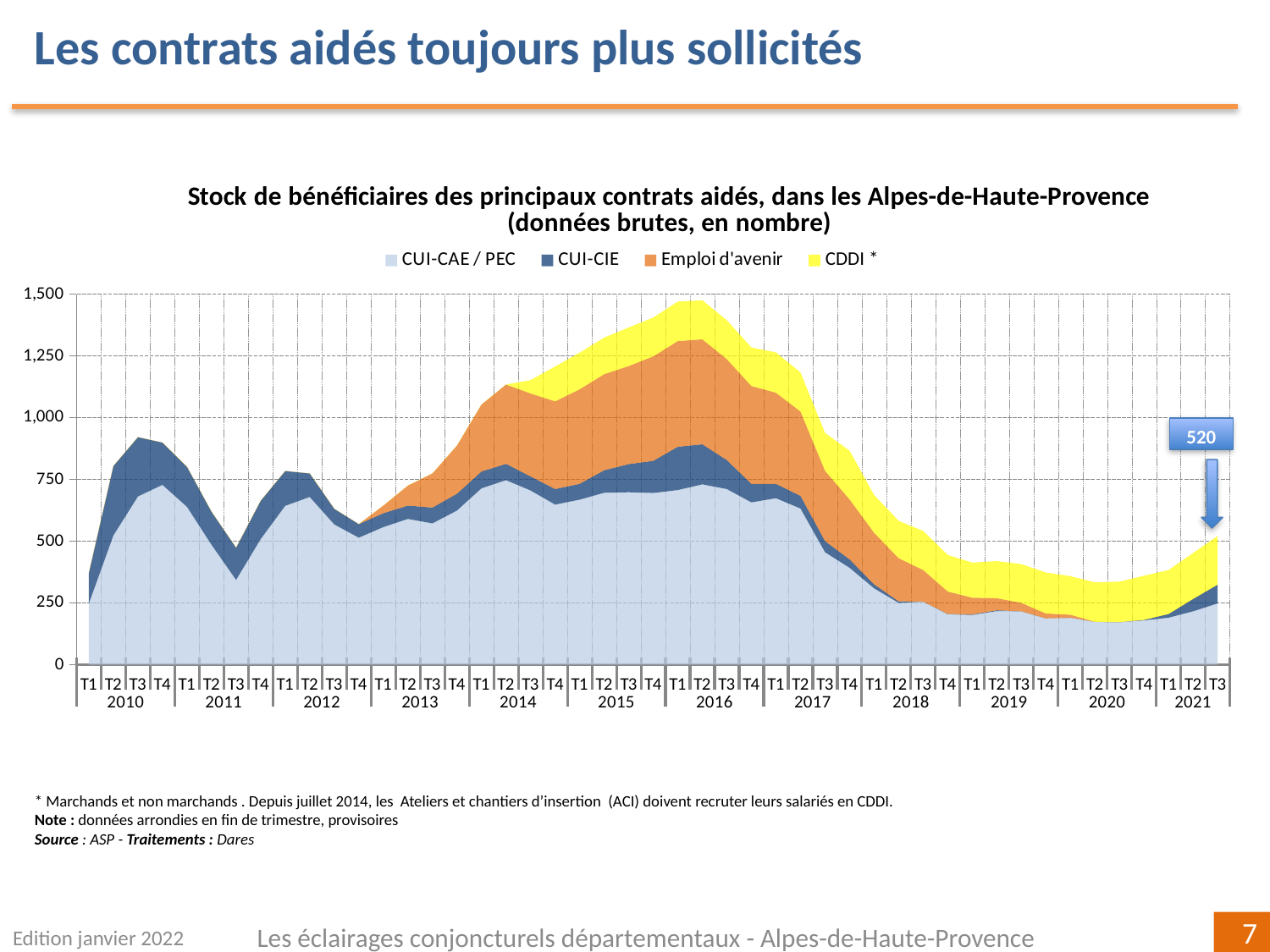
In which year does the total stock of beneficiaries reach its highest level? 2016 Is the total value for T3 2020 greater or less than 500? less How many series does the legend list? 4 Which series is shown in yellow? CDDI * Which is larger, the total for T3 2017 or the total for T3 2021? T3 2017 Is the total value for T1 2016 greater or less than 1,250? greater What is the value shown by the data label at T3 2021? 520 Is the total value for T3 2010 greater or less than 750? greater In which year does the total stock of beneficiaries reach its lowest level? 2020 How many years are shown along the x axis? 12 Do the total values rise or fall between T1 2016 and T3 2020? fall What kind of chart is shown on the slide? Stacked area chart